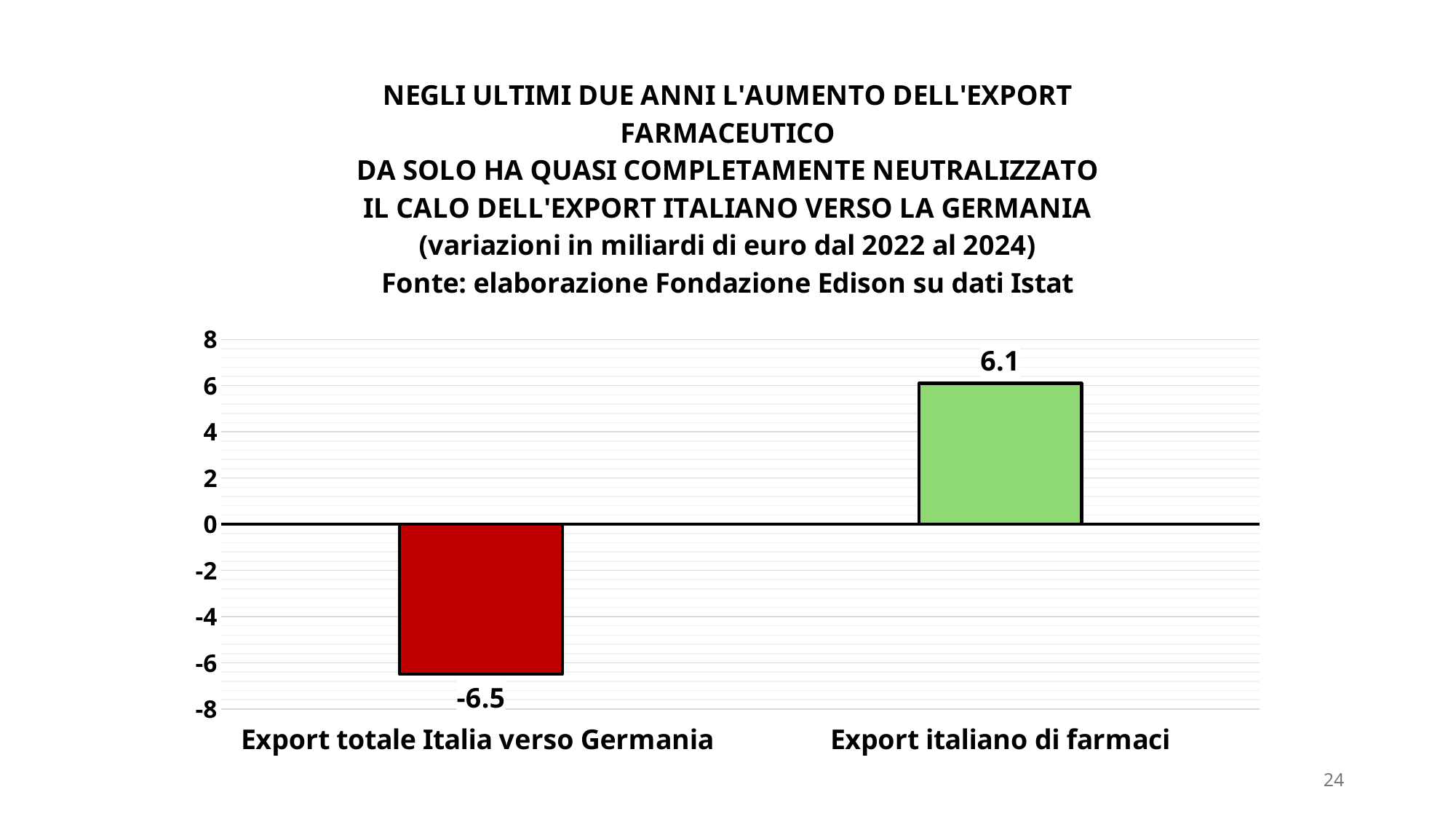
What is the value for Export totale Italia verso Germania? -6.5 What is the difference between the value for Export italiano di farmaci and the value for Export totale Italia verso Germania? 12.6 What kind of chart is shown on the slide? Bar chart What colour is the bar for Export totale Italia verso Germania? Red Which is larger: the value for Export totale Italia verso Germania or the value for Export italiano di farmaci? Export italiano di farmaci According to the chart title, what is the source of the data? Elaborazione Fondazione Edison su dati Istat Is the value for Export italiano di farmaci greater or less than 4? greater Which category has the highest value? Export italiano di farmaci Is the value for Export totale Italia verso Germania greater or less than -4? less How many categories are shown in the chart? 2 Which category has the lowest value? Export totale Italia verso Germania What is the value for Export italiano di farmaci? 6.1